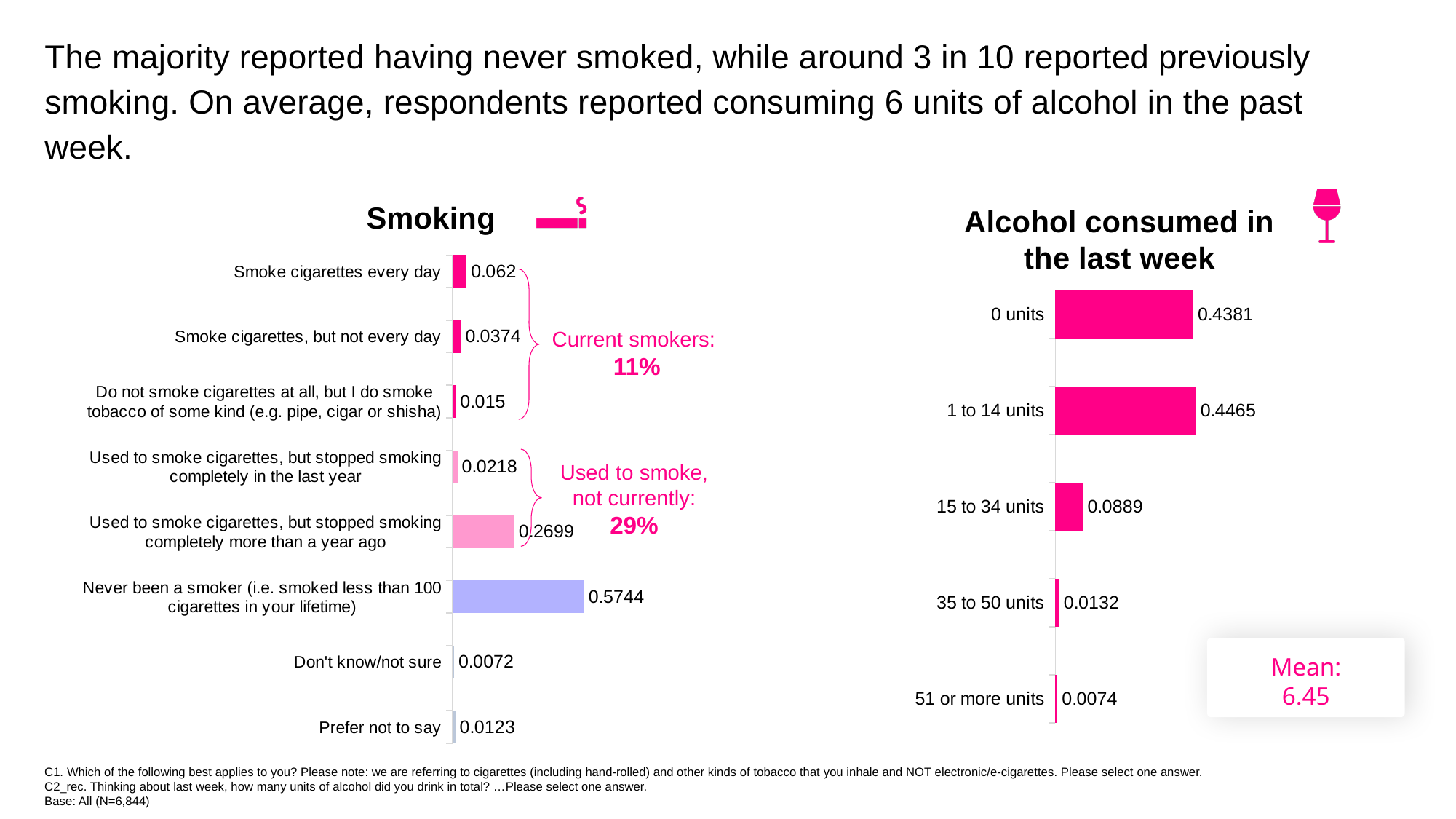
How many categories are shown in the Smoking chart? 8 What type of chart is the 'Alcohol consumed in the last week' chart? Bar chart In the 'Alcohol consumed in the last week' chart, what is the value for '15 to 34 units'? 0.0889 In the Smoking chart, what is the value for 'Smoke cigarettes every day'? 0.062 How many categories are shown in the 'Alcohol consumed in the last week' chart? 5 In the Smoking chart, which category has the lowest value? Don't know/not sure In the 'Alcohol consumed in the last week' chart, which category has the highest value? 1 to 14 units In the Smoking chart, which is larger: 'Smoke cigarettes, but not every day' or 'Prefer not to say'? Smoke cigarettes, but not every day In the Smoking chart, what is the value for 'Never been a smoker (i.e. smoked less than 100 cigarettes in your lifetime)'? 0.5744 In the Smoking chart, what is the difference between 'Used to smoke cigarettes, but stopped smoking completely more than a year ago' and 'Used to smoke cigarettes, but stopped smoking completely in the last year'? 0.2481 What mean value is shown next to the 'Alcohol consumed in the last week' chart? 6.45 In the 'Alcohol consumed in the last week' chart, what is the difference between '1 to 14 units' and '0 units'? 0.0084